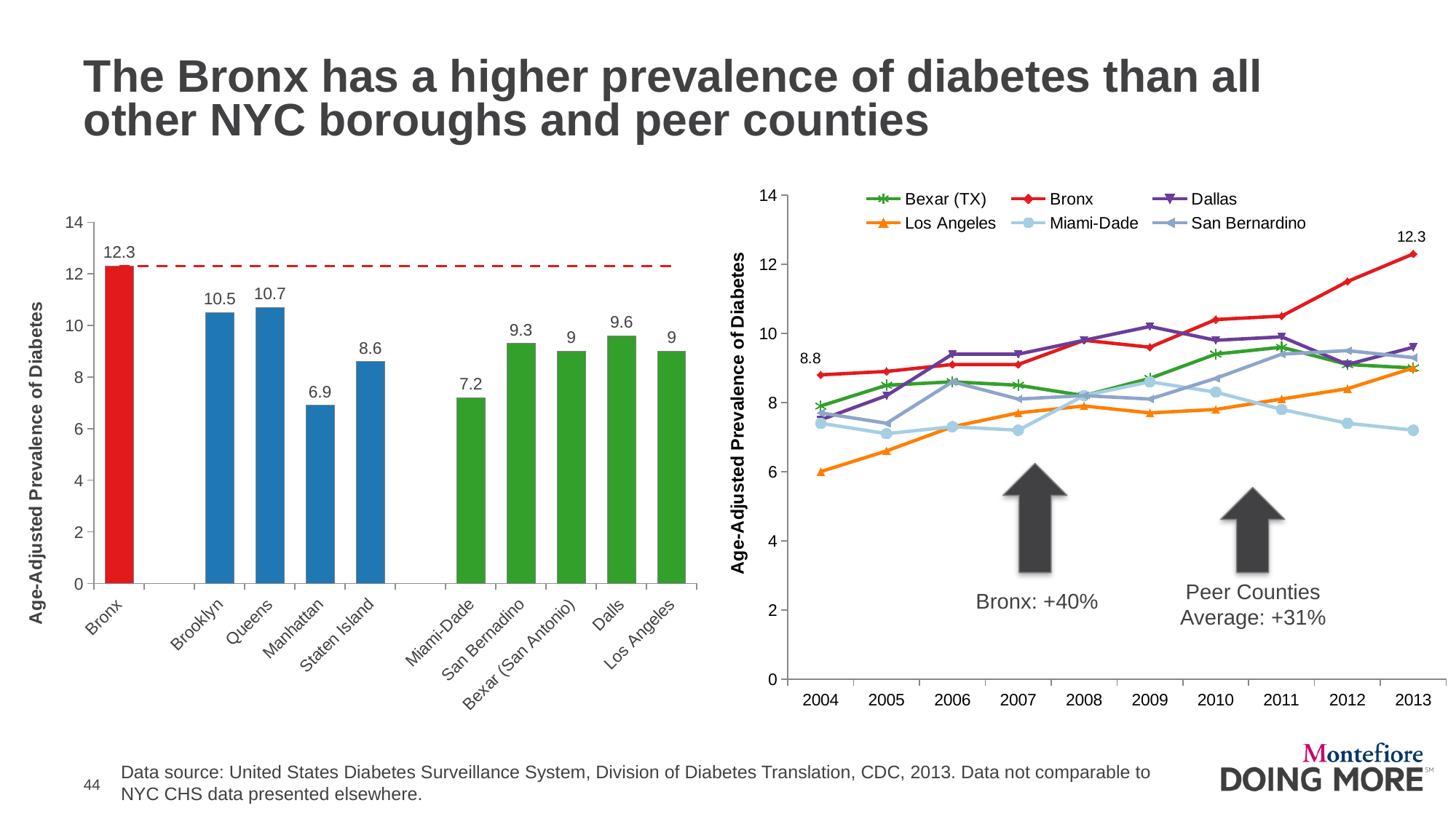
How many categories are shown in the bar chart on the left? 10 What kind of chart is on the left side of the slide? Bar chart In the line chart on the right, does the Bronx line rise or fall from 2004 to 2013? Rises In the bar chart on the left, what is the age-adjusted prevalence of diabetes for the Bronx? 12.3 How many series does the legend of the line chart on the right list? 6 In the bar chart on the left, what is the value for Manhattan? 6.9 In the line chart on the right, what is the value for the Bronx in 2004? 8.8 In the bar chart on the left, which is larger, the value for Staten Island or the value for Miami-Dade? Staten Island In the bar chart on the left, which category has the highest value? Bronx In the bar chart on the left, which category has the lowest value? Manhattan In the line chart on the right, is the value for Los Angeles in 2004 greater or less than 8? less In the bar chart on the left, what is the difference between the values for Queens and Brooklyn? 0.2